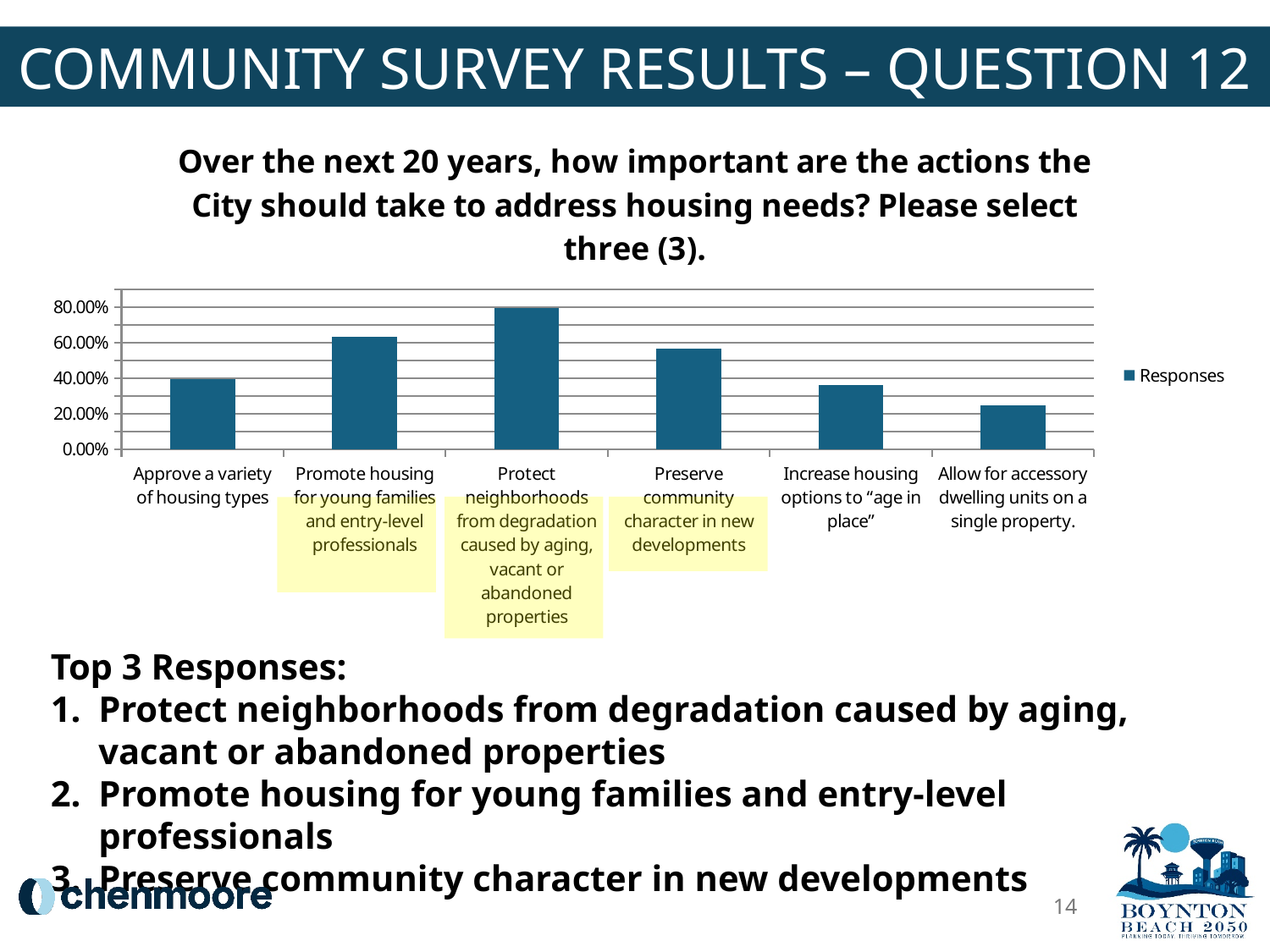
What is the name of the series shown in the chart legend? Responses What kind of chart is shown on the slide? Bar chart Which has a higher response percentage: "Promote housing for young families and entry-level professionals" or "Preserve community character in new developments"? Promote housing for young families and entry-level professionals Which action has the highest response percentage in the chart? Protect neighborhoods from degradation caused by aging, vacant or abandoned properties What is the highest value shown on the chart's vertical axis? 80.00% Is the value for "Increase housing options to “age in place”" greater or less than 40.00%? less How many categories (actions) are shown on the x axis of the chart? 6 Is the value for "Protect neighborhoods from degradation caused by aging, vacant or abandoned properties" greater or less than 60.00%? greater How many series does the chart legend list? 1 Which has a higher response percentage: "Protect neighborhoods from degradation caused by aging, vacant or abandoned properties" or "Approve a variety of housing types"? Protect neighborhoods from degradation caused by aging, vacant or abandoned properties Which action has the lowest response percentage in the chart? Allow for accessory dwelling units on a single property. Is the value for "Allow for accessory dwelling units on a single property." greater or less than 20.00%? greater